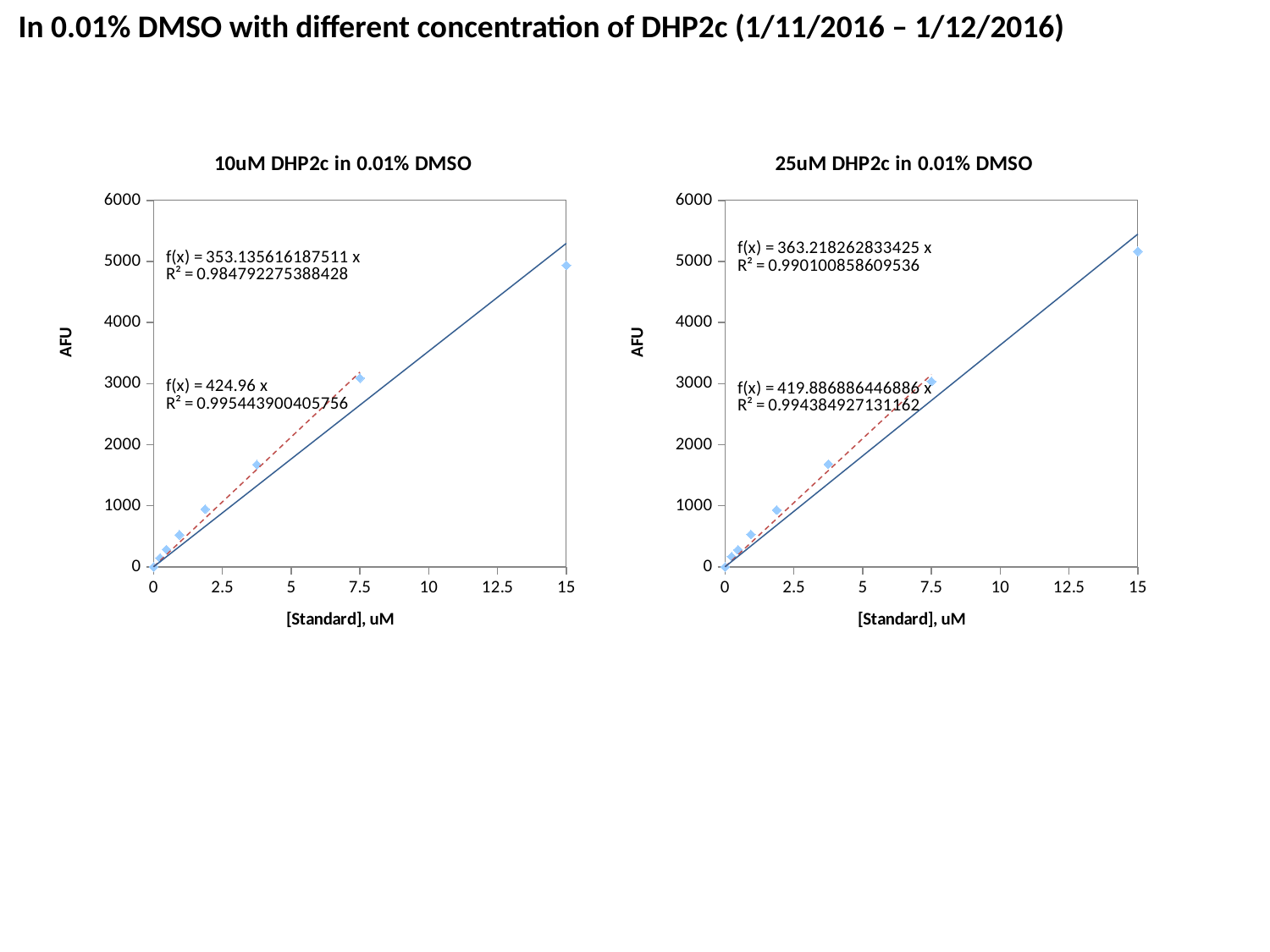
In the '10uM DHP2c in 0.01% DMSO' chart, what is the slope of the trendline fitted through all points, as printed in the upper equation? 353.135616187511 Which chart shows the higher AFU value at 15 uM, '10uM DHP2c in 0.01% DMSO' or '25uM DHP2c in 0.01% DMSO'? 25uM DHP2c in 0.01% DMSO In the '25uM DHP2c in 0.01% DMSO' chart, is the AFU value at 15 uM greater or less than 5000? greater What kind of chart is the '10uM DHP2c in 0.01% DMSO' chart? scatter chart In the '10uM DHP2c in 0.01% DMSO' chart, do the AFU values rise or fall as [Standard], uM increases? rise In the '10uM DHP2c in 0.01% DMSO' chart, is the AFU value at 7.5 uM greater or less than 2000? greater In the '25uM DHP2c in 0.01% DMSO' chart, is the AFU value at 3.75 uM greater or less than 2000? less What is the label of the x axis on the '25uM DHP2c in 0.01% DMSO' chart? [Standard], uM In the '25uM DHP2c in 0.01% DMSO' chart, what R² value is printed for the upper equation f(x) = 363.218262833425 x? 0.990100858609536 In the '25uM DHP2c in 0.01% DMSO' chart, do the AFU values rise or fall as [Standard], uM increases? rise What is the label of the y axis on the '10uM DHP2c in 0.01% DMSO' chart? AFU